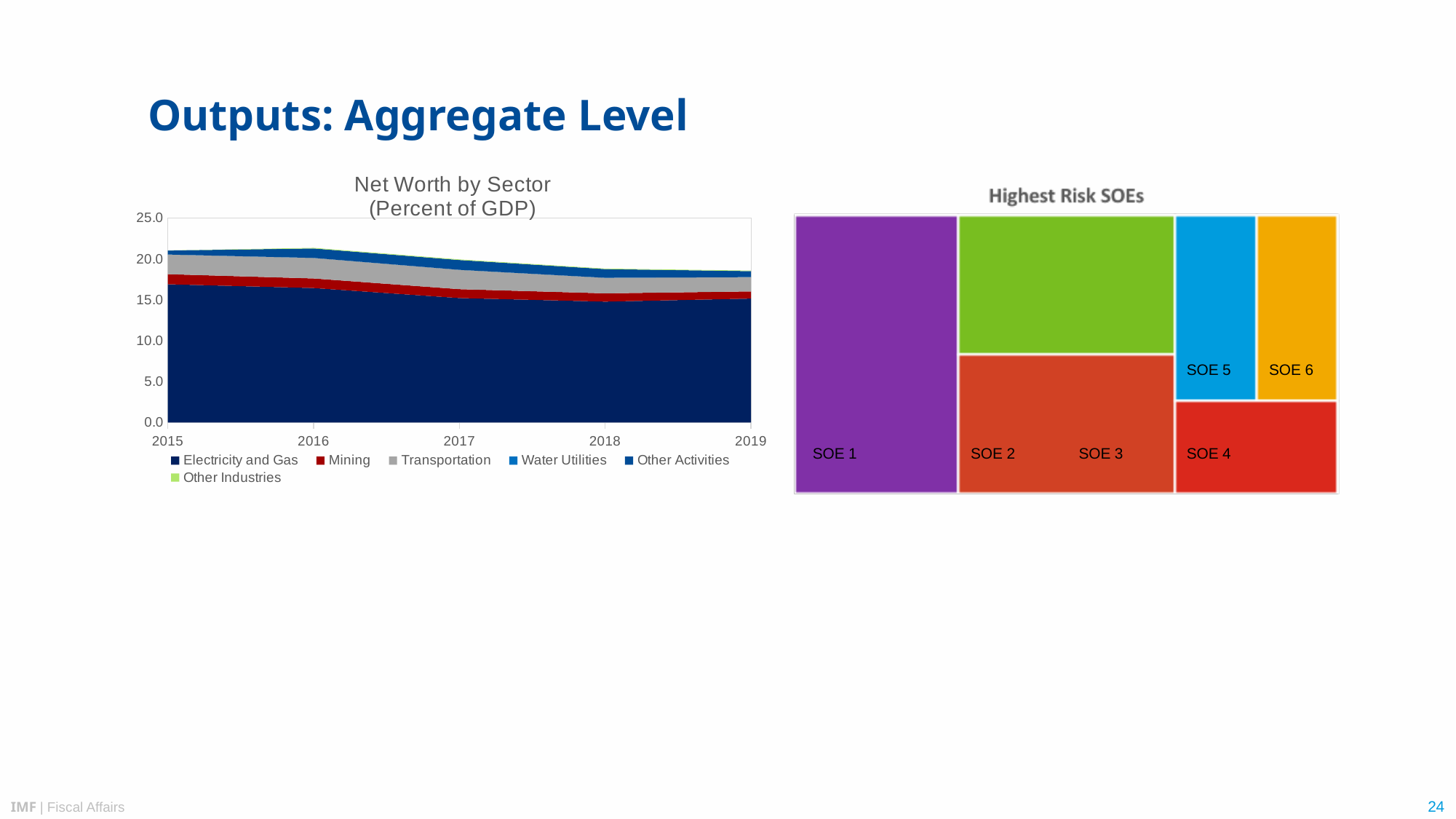
How many years are shown on the x axis of the 'Net Worth by Sector' chart? 5 How many series does the legend of the 'Net Worth by Sector' chart list? 6 In the 'Highest Risk SOEs' chart, which is larger, SOE 2 or SOE 5? SOE 2 In the 'Net Worth by Sector' chart, is the total net worth in 2019 greater or less than 20.0? less In the 'Highest Risk SOEs' chart, which SOE has the largest area? SOE 1 How many SOEs are shown in the 'Highest Risk SOEs' chart? 6 In the 'Net Worth by Sector' chart, is the value for Electricity and Gas in 2019 greater or less than 10.0? greater In the 'Net Worth by Sector' chart, which sector accounts for the largest share of net worth? Electricity and Gas What kind of chart is the 'Highest Risk SOEs' chart on the right? Treemap In the 'Net Worth by Sector' chart, does the total net worth rise or fall from 2015 to 2019? Fall What kind of chart is the 'Net Worth by Sector (Percent of GDP)' chart on the left? Stacked area chart In the 'Net Worth by Sector' chart, is the value for Electricity and Gas in 2015 greater or less than 15.0? greater